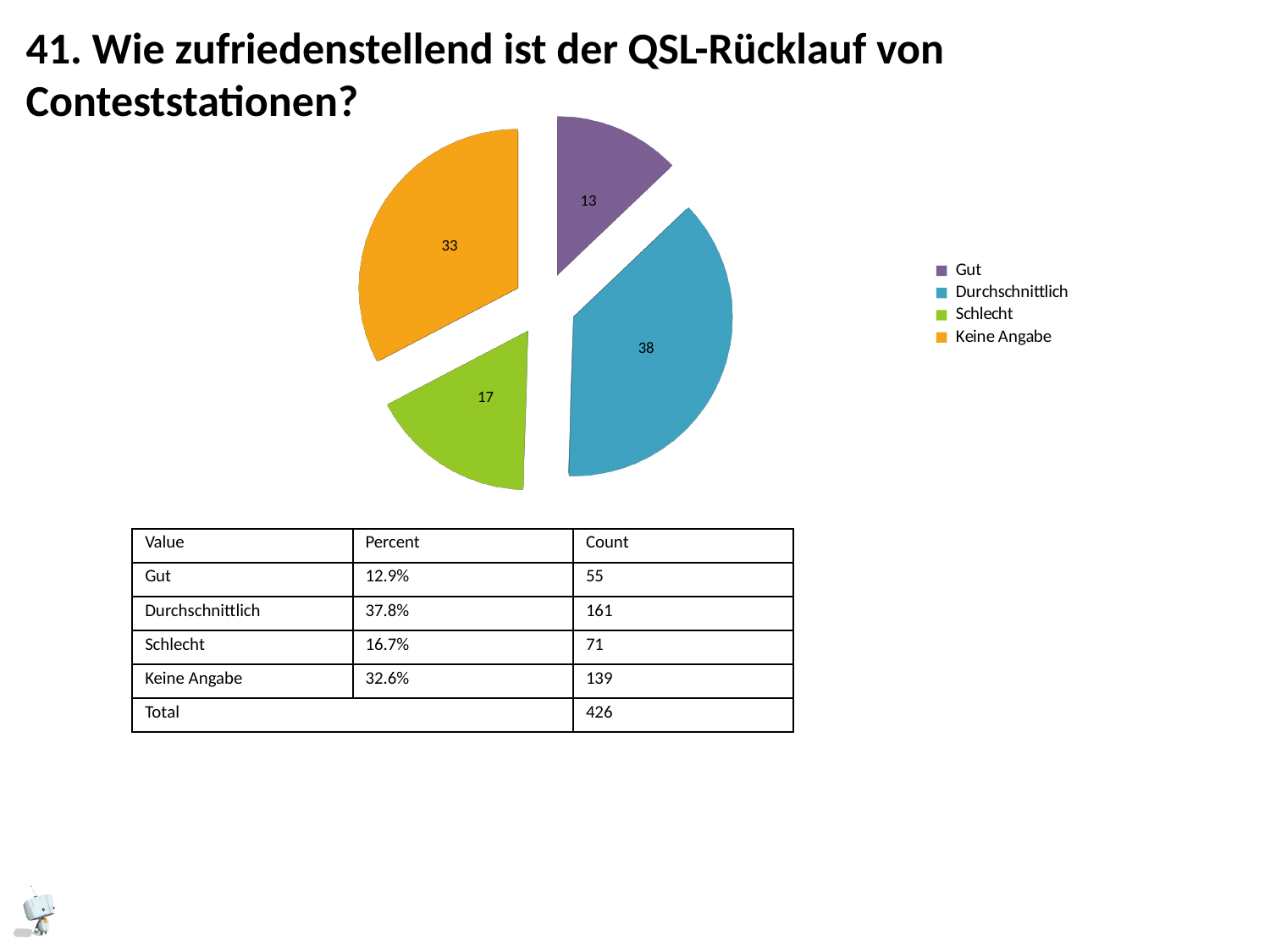
How many entries does the legend of the pie chart list? 4 What is the difference between the data labels of the Durchschnittlich and Gut slices in the pie chart? 25 Which category has the smallest slice in the pie chart? Gut How many slices does the pie chart have? 4 What is the data label on the Keine Angabe slice of the pie chart? 33 What is the data label on the Gut slice of the pie chart? 13 Which category has the largest slice in the pie chart? Durchschnittlich What kind of chart is shown on the slide? pie chart Which slice is larger in the pie chart, Schlecht or Keine Angabe? Keine Angabe What is the data label on the Durchschnittlich slice of the pie chart? 38 What is the data label on the Schlecht slice of the pie chart? 17 What colour is the Keine Angabe slice in the pie chart? orange